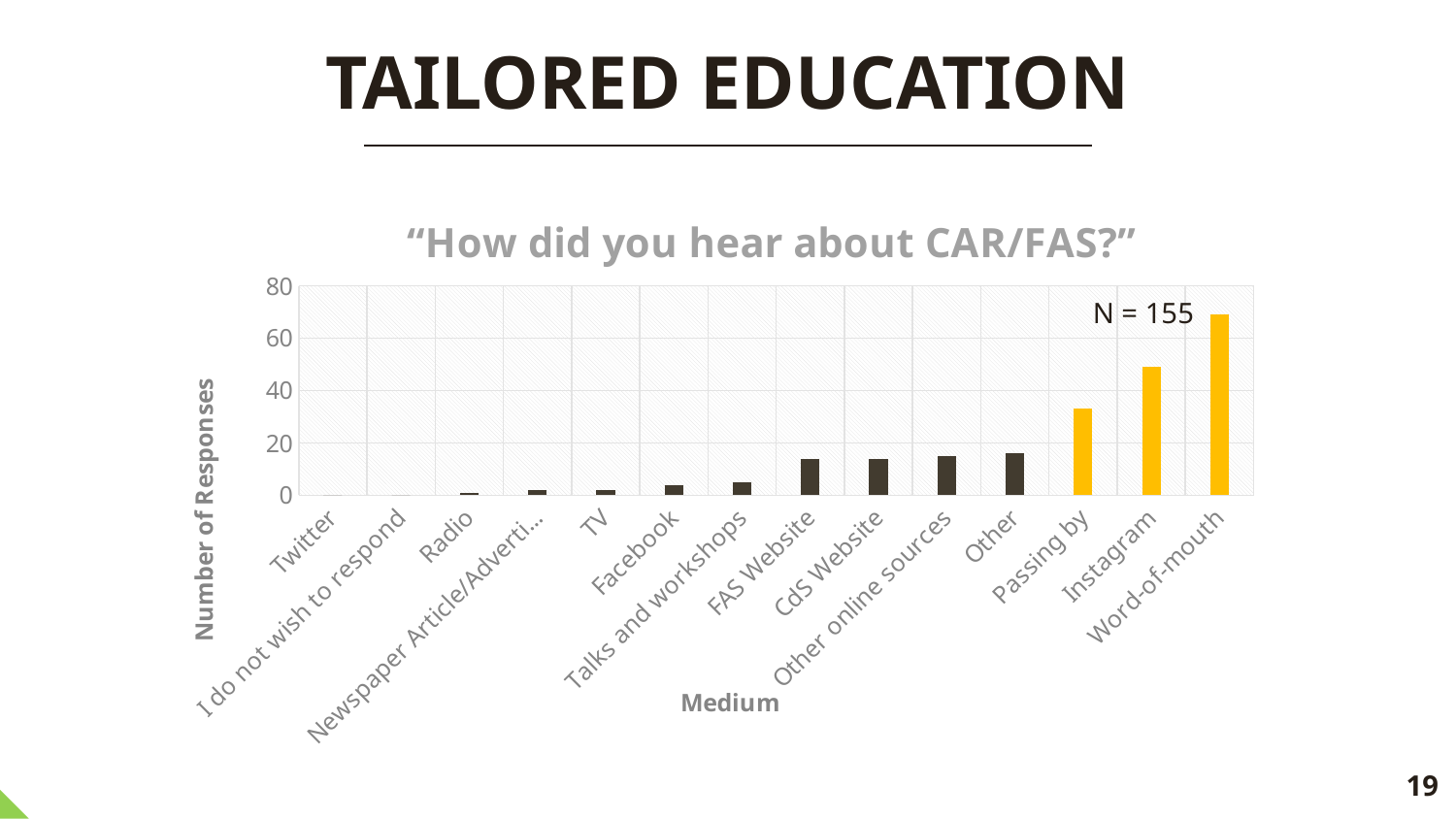
Which has more responses, Instagram or Passing by? Instagram What is the title of the chart? "How did you hear about CAR/FAS?" What kind of chart is shown on the slide? bar chart Is the value for Instagram greater or less than 40? greater Is the value for Word-of-mouth greater or less than 60? greater Is the value for Facebook greater or less than 20? less Which medium has the highest number of responses? Word-of-mouth Do the values generally rise or fall moving from left to right along the x axis? rise Which has more responses, Other or Facebook? Other How many mediums (categories) are shown on the x axis? 14